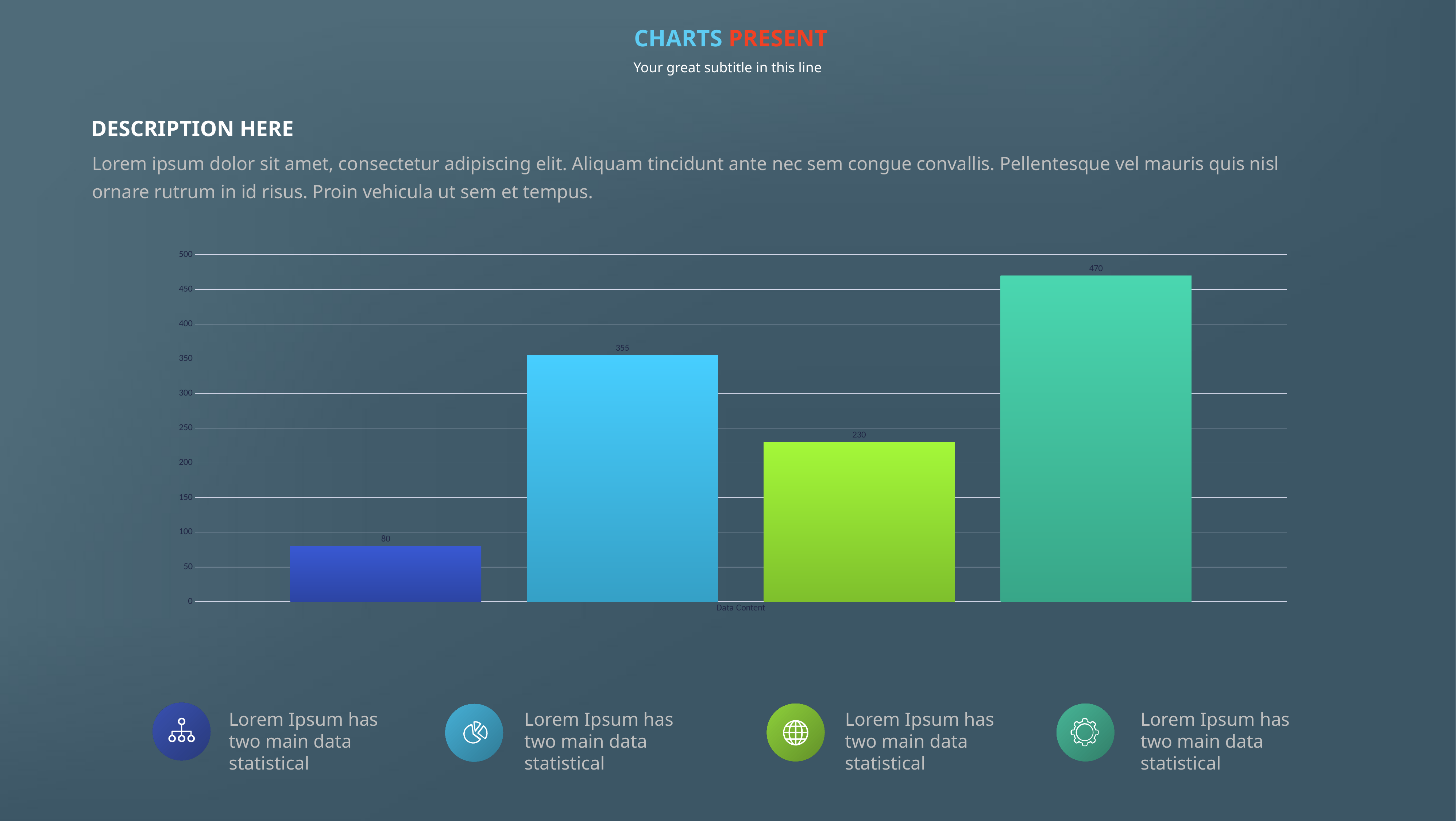
How many bars are plotted in the chart? 4 Do the bar values rise or fall from the third bar to the fourth bar? rise What is the difference between the teal bar and the light blue bar? 115 What is the value of the green bar (third from the left)? 230 What is the value of the light blue bar (second from the left)? 355 What label appears below the horizontal axis of the chart? Data Content Which bar has the highest value? the teal bar (fourth from the left), 470 What is the value of the dark blue bar (first from the left)? 80 Which bar has the lowest value? the dark blue bar (first from the left), 80 Which is larger, the light blue bar or the green bar? the light blue bar What type of chart is shown on the slide? bar chart What is the value of the teal bar (fourth from the left)? 470